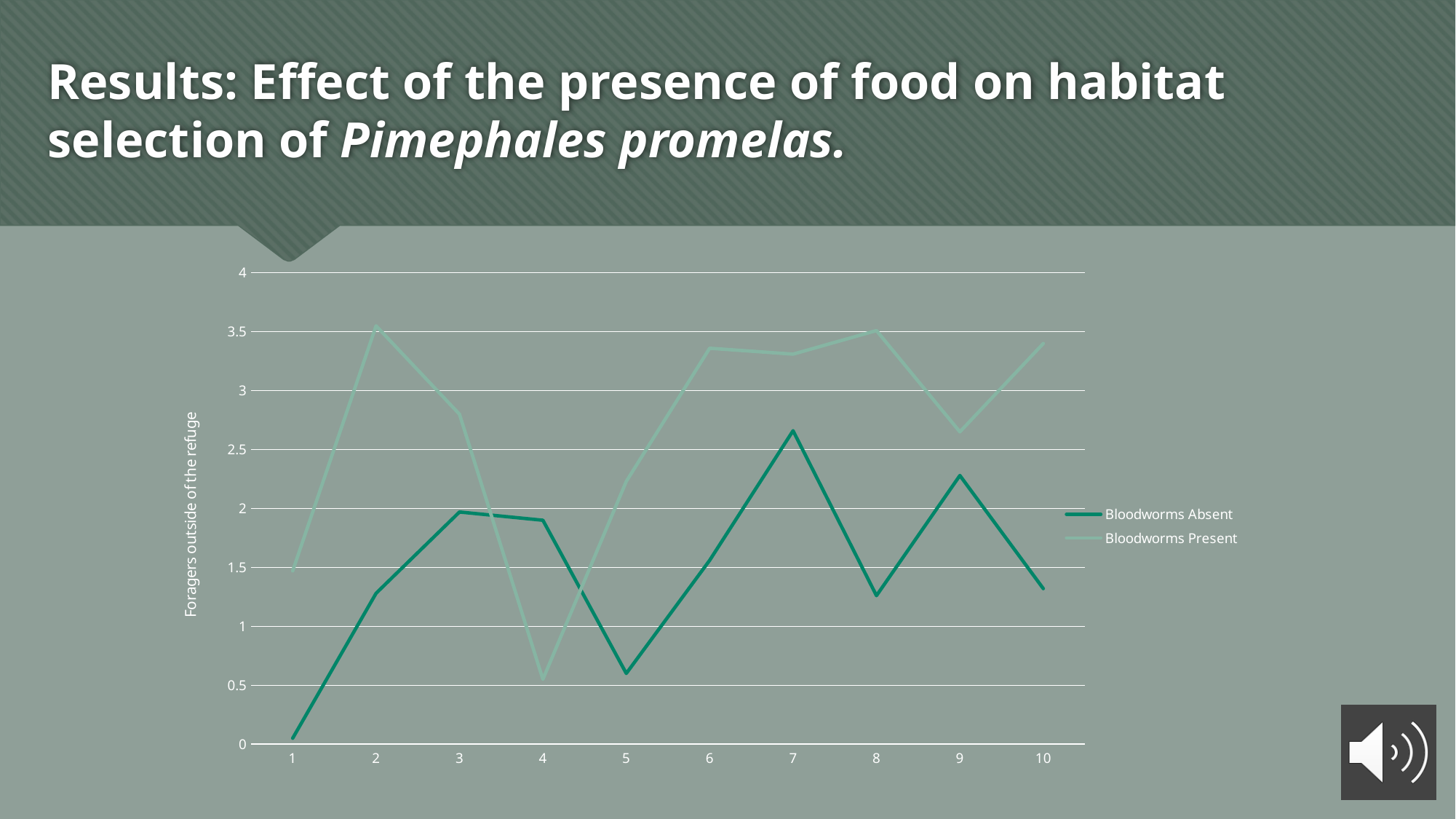
At which x-axis point does the Bloodworms Absent series reach its highest value? 7 At point 10, which series has the larger value, Bloodworms Absent or Bloodworms Present? Bloodworms Present How many points are plotted along the x axis for each series? 10 At which x-axis point does the Bloodworms Present series reach its lowest value? 4 Is the value for Bloodworms Absent at point 7 greater or less than 2.5? greater How many series does the legend list? 2 What kind of chart is shown on the slide? line chart Is the value for Bloodworms Present at point 4 greater or less than 1? less Is the value for Bloodworms Present at point 2 greater or less than 3? greater At which x-axis point does the Bloodworms Absent series reach its lowest value? 1 At point 4, which series has the larger value, Bloodworms Absent or Bloodworms Present? Bloodworms Absent What is the label on the vertical axis of the chart? Foragers outside of the refuge